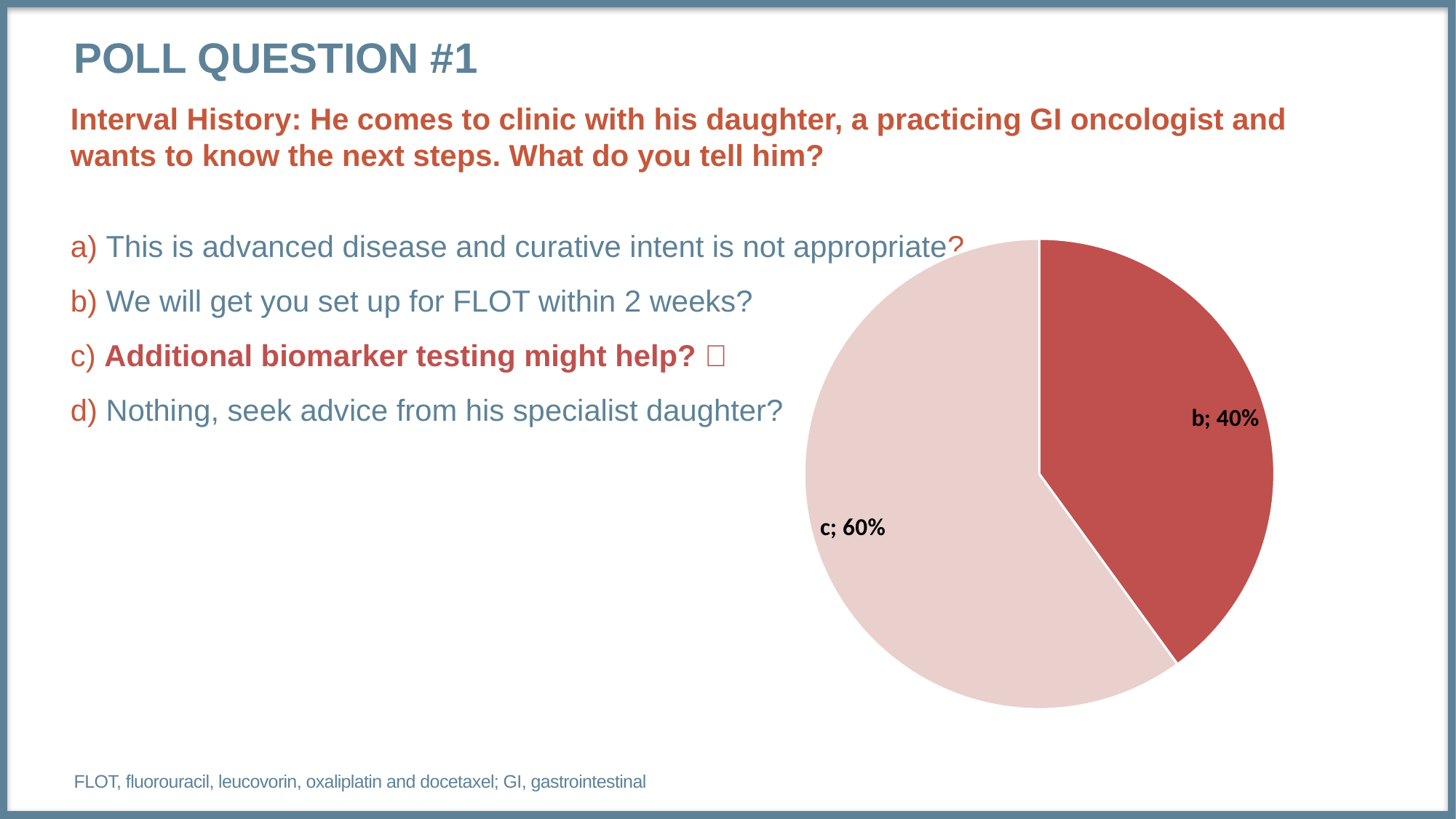
What share of the pie does slice c have? 60% Which slice of the pie is the smallest? b Which slice of the pie is coloured dark red? b What share of the pie does slice b have? 40% What kind of chart is shown on the slide? pie chart What is the difference in percentage points between slice c and slice b? 20% How many slices does the pie chart have? 2 Which slice of the pie is coloured light pink? c Which is larger, slice b or slice c? c What is the combined share of slices b and c? 100% Which slice of the pie is the largest? c